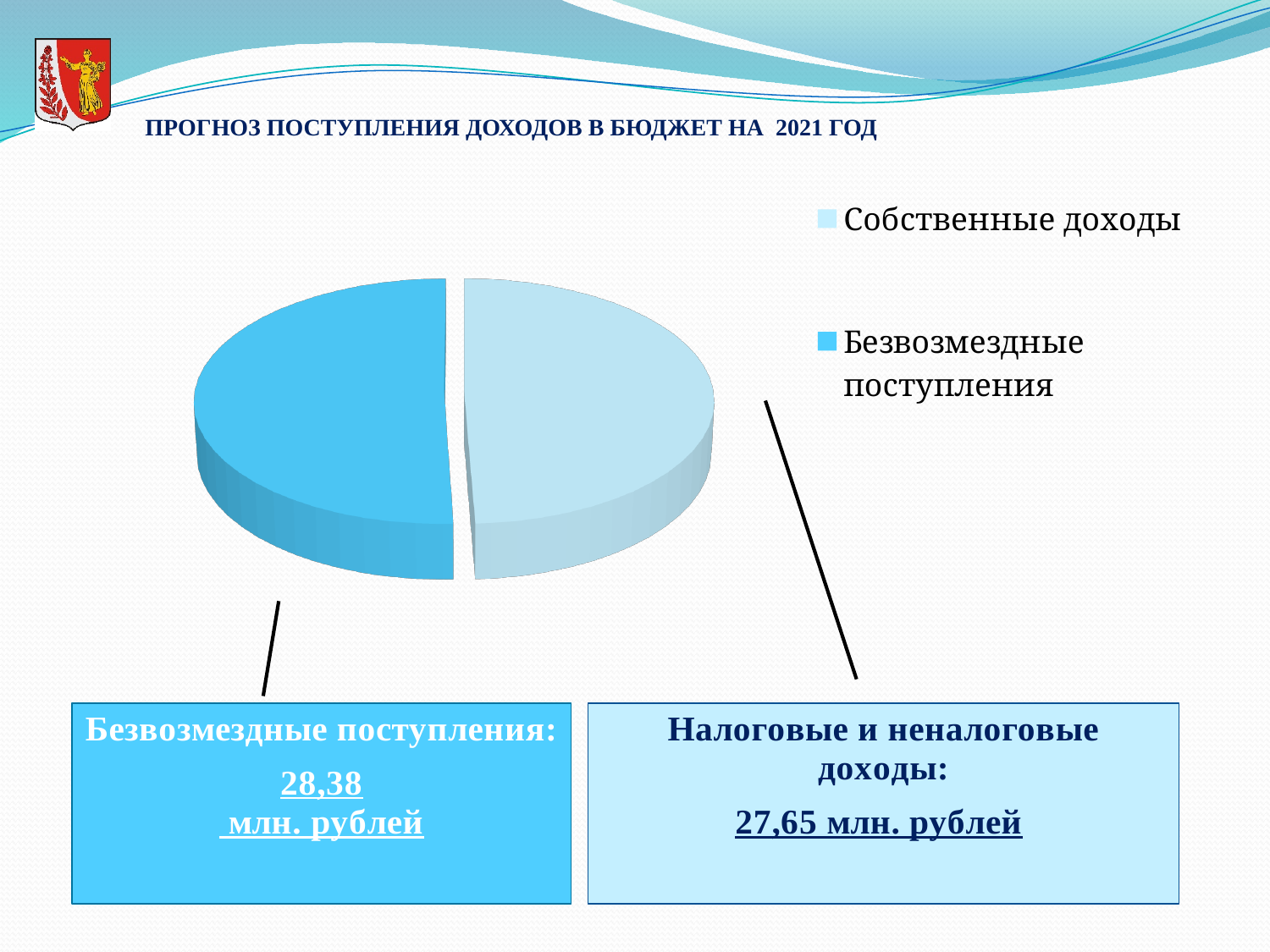
What value is given for Налоговые и неналоговые доходы on the slide? 27,65 млн. рублей What value is given for Безвозмездные поступления on the slide? 28,38 млн. рублей Which legend entry is shown in the darker blue colour in the pie chart? Безвозмездные поступления What kind of chart is shown on the slide? pie chart Which year does the pie chart's income forecast refer to? 2021 How many entries does the legend of the pie chart list? 2 How many slices does the pie chart have? 2 What is the difference between the value for Безвозмездные поступления (28,38 млн. рублей) and the value for Налоговые и неналоговые доходы (27,65 млн. рублей)? 0,73 млн. рублей What is the title of the slide containing the pie chart? ПРОГНОЗ ПОСТУПЛЕНИЯ ДОХОДОВ В БЮДЖЕТ НА 2021 ГОД